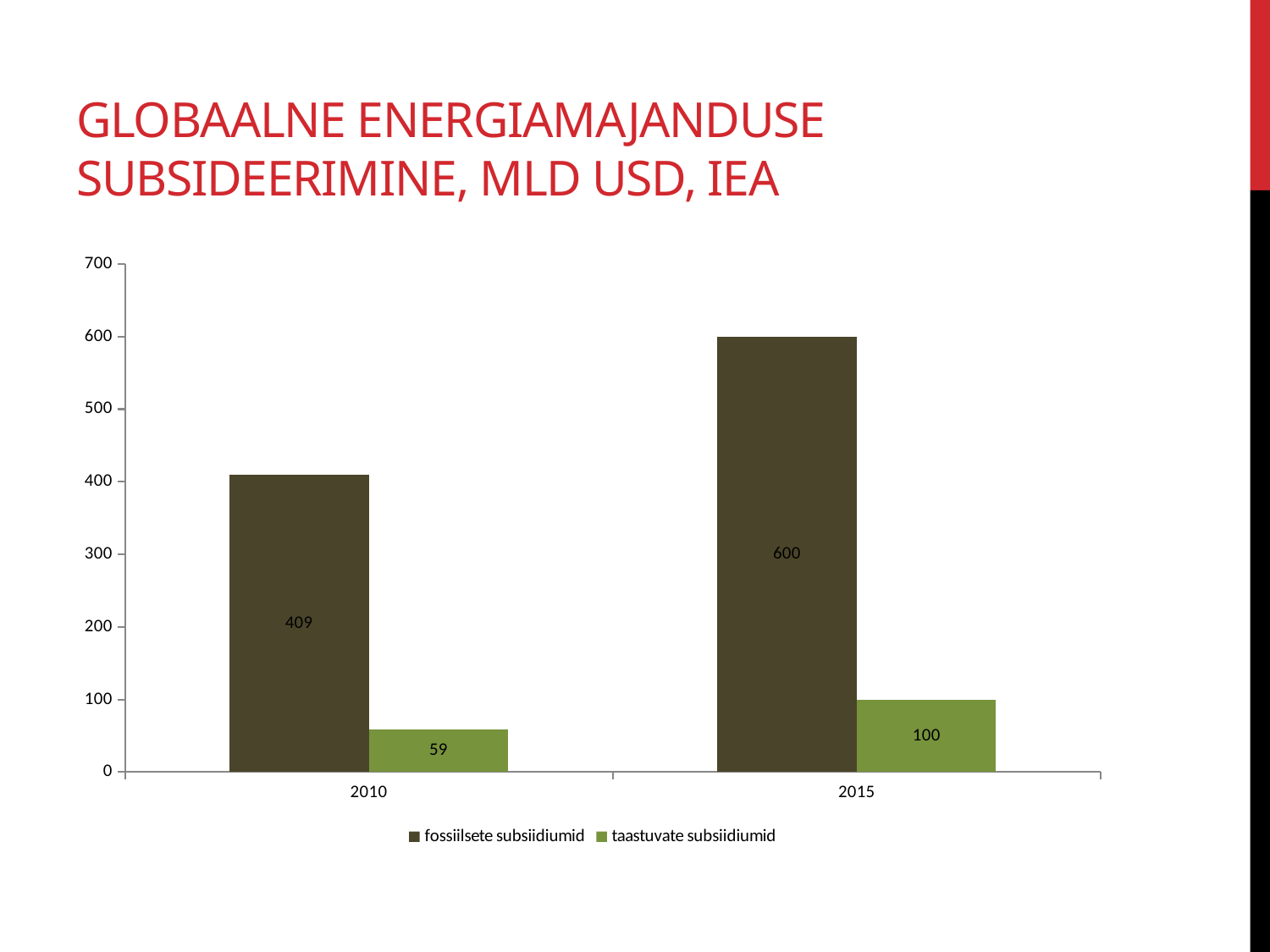
What is the value for taastuvate subsiidiumid in 2010? 59 What is the value for taastuvate subsiidiumid in 2015? 100 Which year has the highest value for fossiilsete subsiidiumid? 2015 How many series does the legend list? 2 What is the value for fossiilsete subsiidiumid in 2010? 409 What is the difference between fossiilsete subsiidiumid in 2015 and in 2010? 191 Which year has the lowest value for taastuvate subsiidiumid? 2010 What kind of chart is shown on the slide? bar chart What is the value for fossiilsete subsiidiumid in 2015? 600 How many years are shown on the x axis? 2 Does the value for taastuvate subsiidiumid rise or fall from 2010 to 2015? rise Which is larger in 2015: fossiilsete subsiidiumid or taastuvate subsiidiumid? fossiilsete subsiidiumid